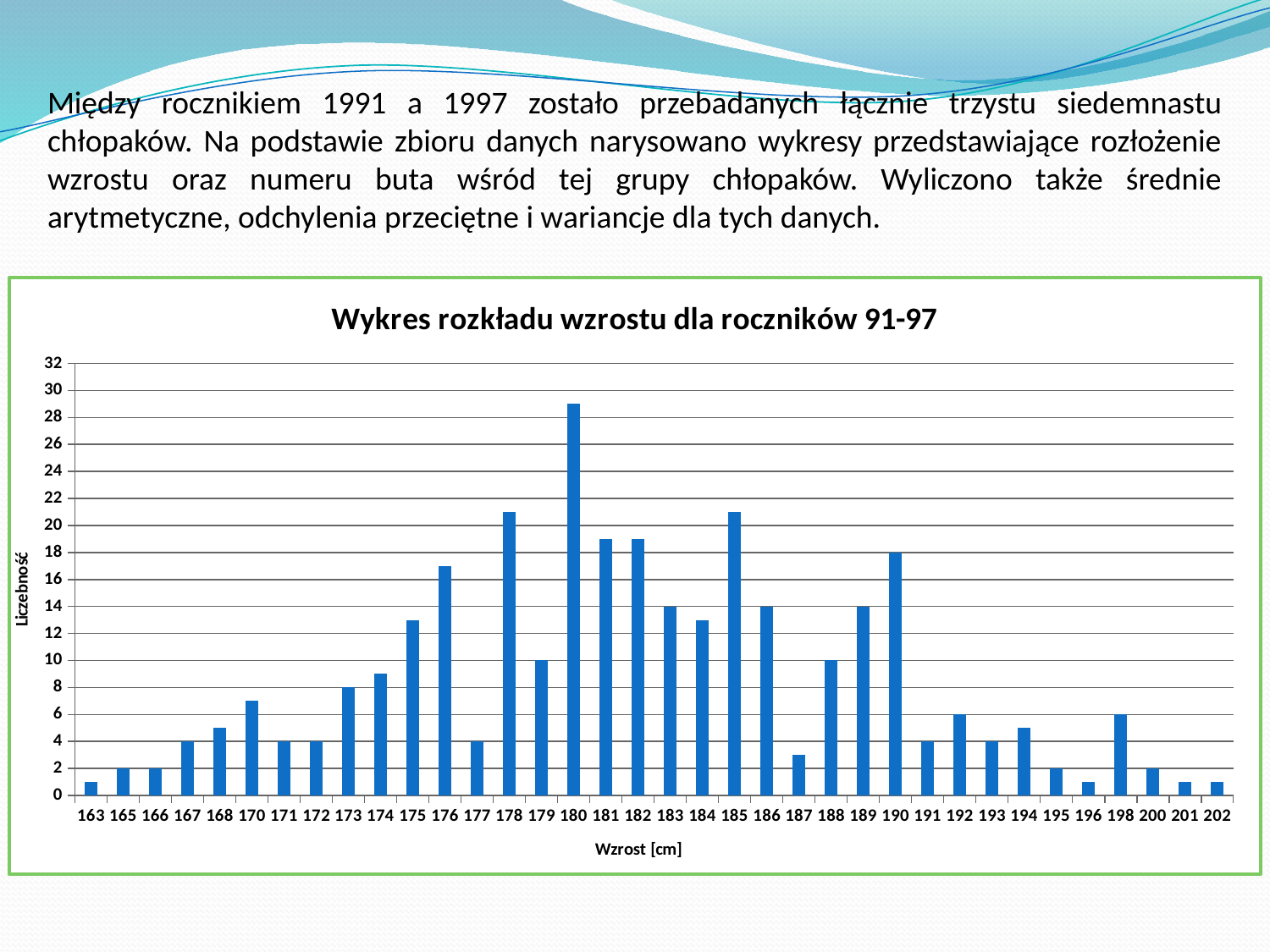
What is the Liczebność for height 183? 14 What is the Liczebność for height 179? 10 What is the label of the vertical axis? Liczebność What type of chart is shown on the slide? bar chart What is the Liczebność for height 192? 6 Is the value for height 187 greater or less than 4? less What is the difference between the Liczebność for height 190 and height 179? 8 Which height (Wzrost) has the highest Liczebność? 180 What is the title of the chart? Wykres rozkładu wzrostu dla roczników 91-97 Is the value for height 180 greater or less than 28? greater What is the Liczebność for height 190? 18 Which has a higher Liczebność, height 178 or height 176? 178